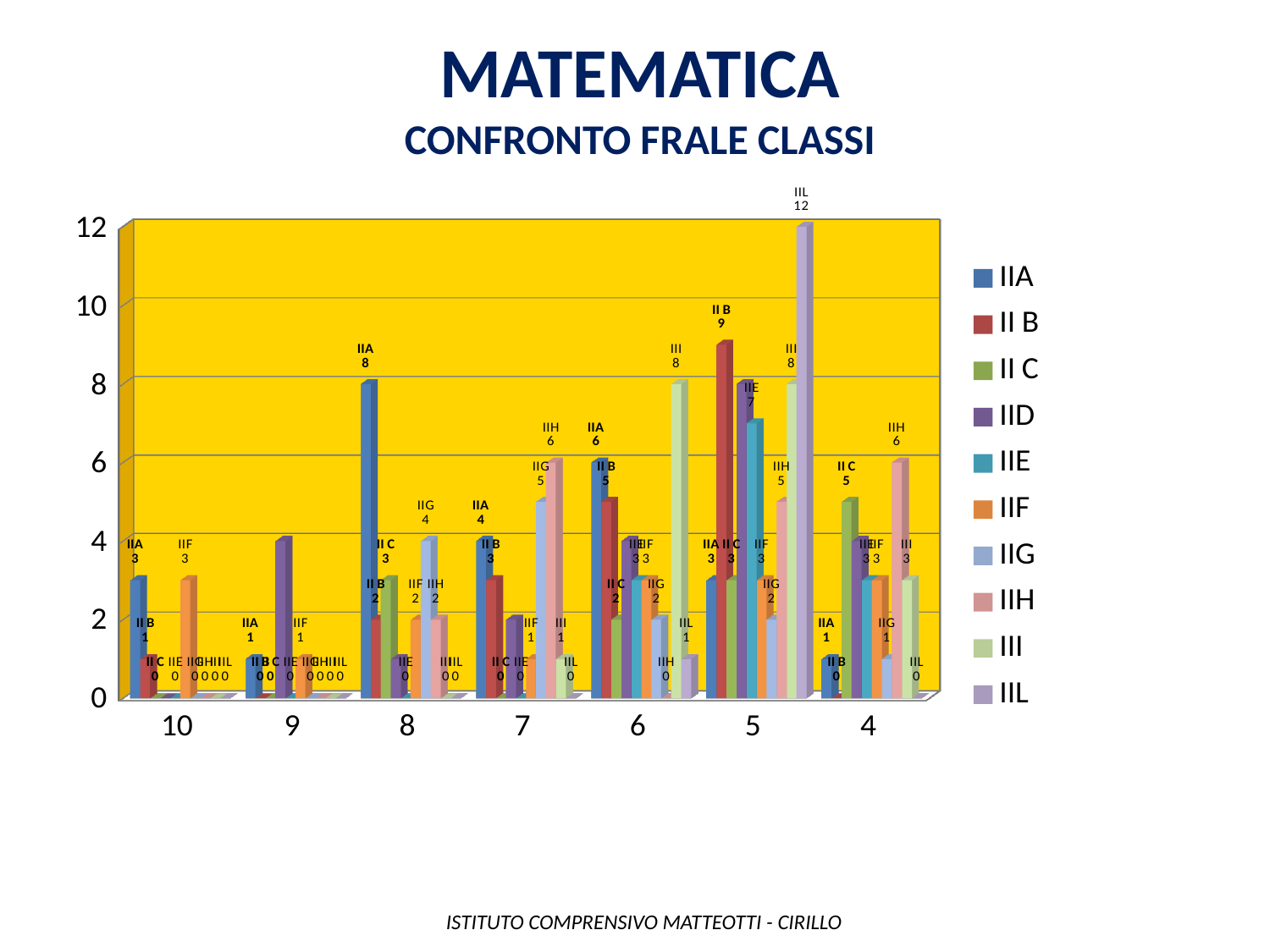
What is the difference between the IIL value and the II B value at grade 5? 3 What is the value for IIA at grade 8? 8 Which is larger: the IIA value at grade 6 or the IIA value at grade 7? grade 6 What kind of chart is shown on the slide? bar chart What is the value for IIL at grade 5? 12 How many grade categories are shown on the x axis? 7 What is the value for II B at grade 5? 9 What is the value for IIG at grade 7? 5 Which series has the highest value at grade 4? IIH How many series does the legend list? 10 What is the value for IIH at grade 4? 6 Is the value for IID at grade 5 greater or less than 4? greater